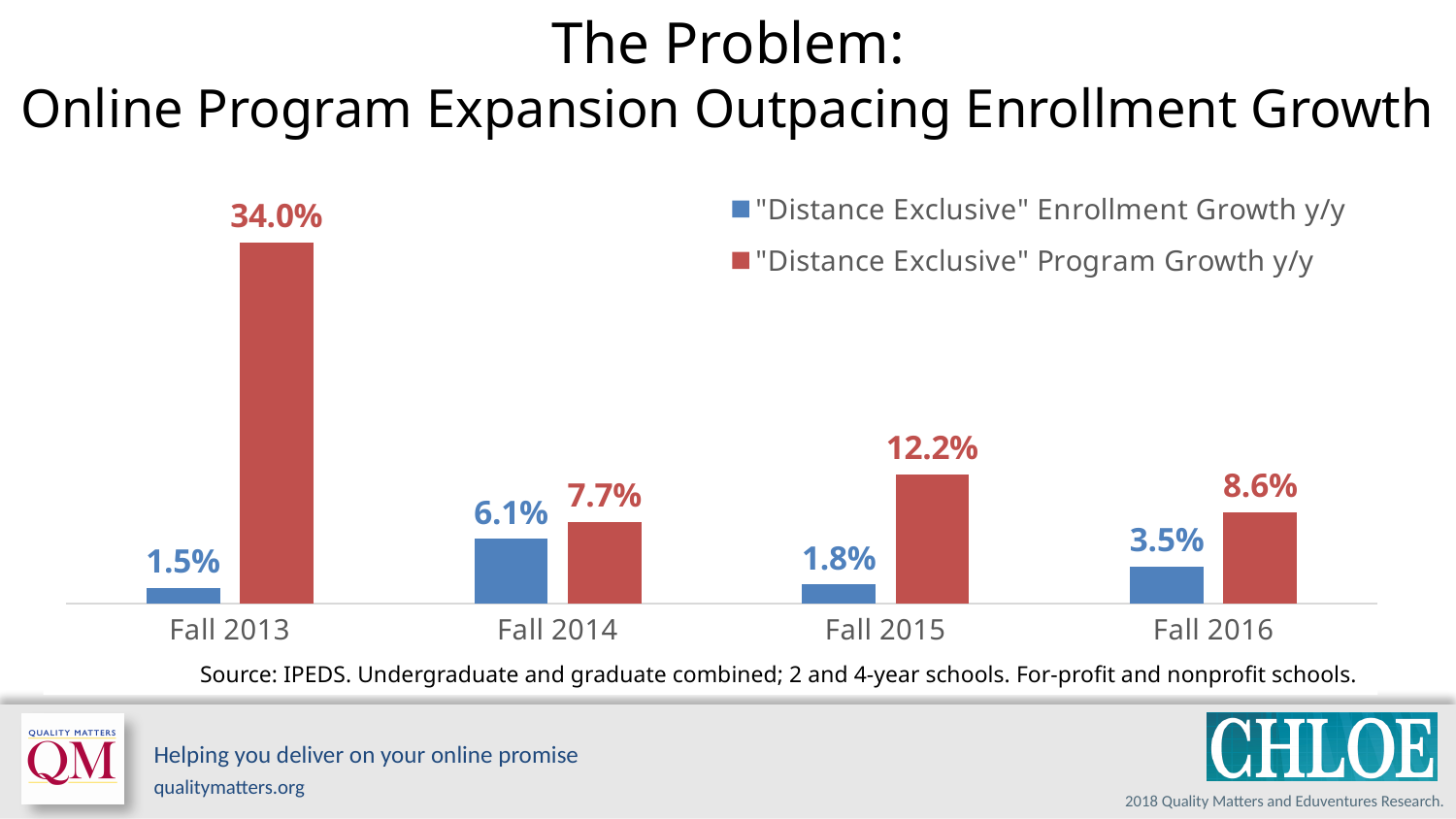
What is the "Distance Exclusive" Program Growth y/y value for Fall 2013? 34.0% What is the "Distance Exclusive" Program Growth y/y value for Fall 2015? 12.2% Which is larger in Fall 2015: Enrollment Growth y/y or Program Growth y/y? Program Growth y/y What kind of chart is shown on the slide? Bar chart What is the "Distance Exclusive" Enrollment Growth y/y value for Fall 2014? 6.1% What is the difference between Program Growth and Enrollment Growth in Fall 2016? 5.1% What is the "Distance Exclusive" Enrollment Growth y/y value for Fall 2016? 3.5% How many periods are shown on the x axis? 4 What colour are the "Distance Exclusive" Program Growth y/y bars? Red In which period is "Distance Exclusive" Enrollment Growth y/y lowest? Fall 2013 How many series does the legend list? 2 In which period is "Distance Exclusive" Program Growth y/y highest? Fall 2013